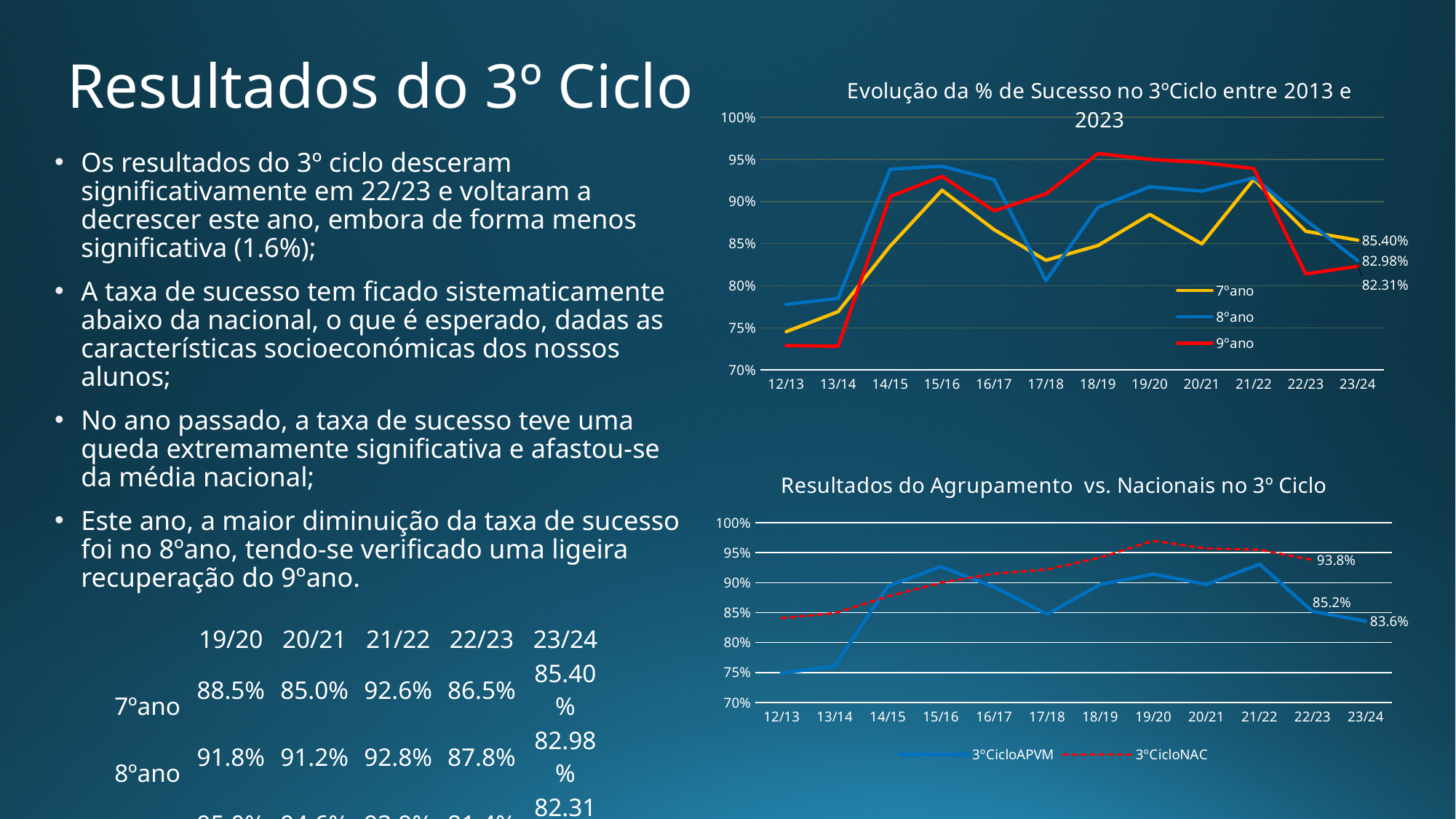
In the top chart 'Evolução da % de Sucesso no 3ºCiclo', what is the value for 9ºano in 23/24? 82.31% In the top chart 'Evolução da % de Sucesso no 3ºCiclo', what is the value for 8ºano in 23/24? 82.98% In the bottom chart 'Resultados do Agrupamento vs. Nacionais no 3º Ciclo', how many series does the legend list? 2 In the top chart 'Evolução da % de Sucesso no 3ºCiclo', what is the difference between the 7ºano and 8ºano values in 23/24? 2.42 percentage points In the bottom chart 'Resultados do Agrupamento vs. Nacionais no 3º Ciclo', is the value for 3ºCicloAPVM in 12/13 greater or less than 80%? less In the bottom chart 'Resultados do Agrupamento vs. Nacionais no 3º Ciclo', what is the value for 3ºCicloAPVM in 23/24? 83.6% In the top chart 'Evolução da % de Sucesso no 3ºCiclo', how many series does the legend list? 3 In the top chart 'Evolução da % de Sucesso no 3ºCiclo', what is the value for 7ºano in 23/24? 85.40% In the top chart 'Evolução da % de Sucesso no 3ºCiclo', how many school years are shown on the x axis? 12 What kind of chart is the top chart titled 'Evolução da % de Sucesso no 3ºCiclo entre 2013 e 2023'? Line chart In the top chart 'Evolução da % de Sucesso no 3ºCiclo', which series has the highest value in 23/24? 7ºano In the top chart 'Evolução da % de Sucesso no 3ºCiclo', is the value for 9ºano in 12/13 greater or less than 75%? less